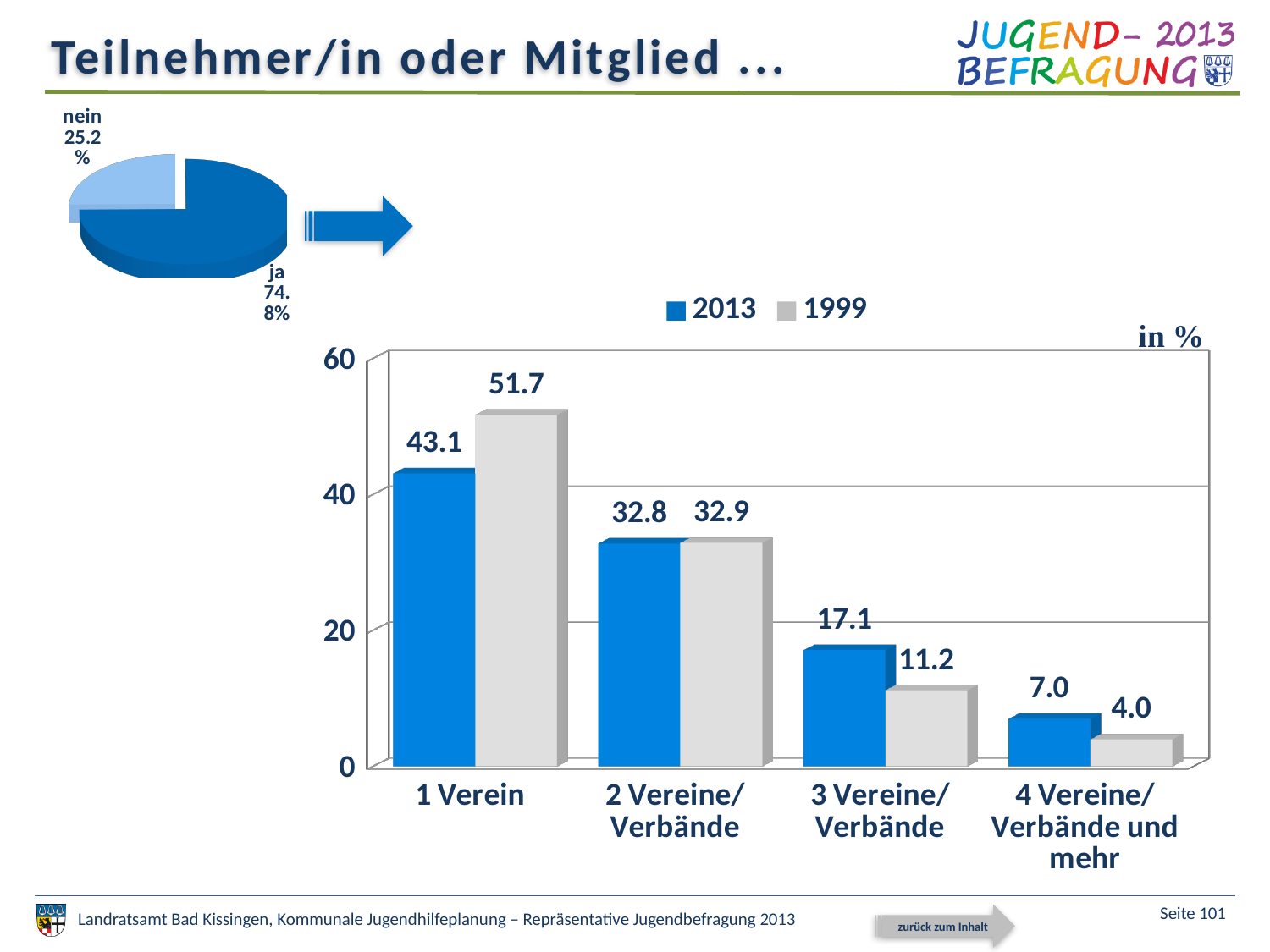
What kind of chart is the chart at the top left of the slide? pie chart In the bar chart, which category has the lowest value in the 2013 series? 4 Vereine/Verbände und mehr In the bar chart, what is the value for 1 Verein in the 2013 series? 43.1 In the bar chart, which category has the highest value in the 1999 series? 1 Verein In the bar chart, what is the difference between the 1999 and 2013 values for 1 Verein? 8.6 In the bar chart, what is the 1999 value for 4 Vereine/Verbände und mehr? 4.0 In the bar chart, what is the value for 1 Verein in the 1999 series? 51.7 How many categories are shown on the x axis of the bar chart? 4 How many series does the legend of the bar chart list? 2 In the bar chart, which is larger for 3 Vereine/Verbände: the 2013 value or the 1999 value? 2013 In the pie chart at the top left, what share is labelled "ja"? 74.8% In the bar chart, what is the 2013 value for 3 Vereine/Verbände? 17.1